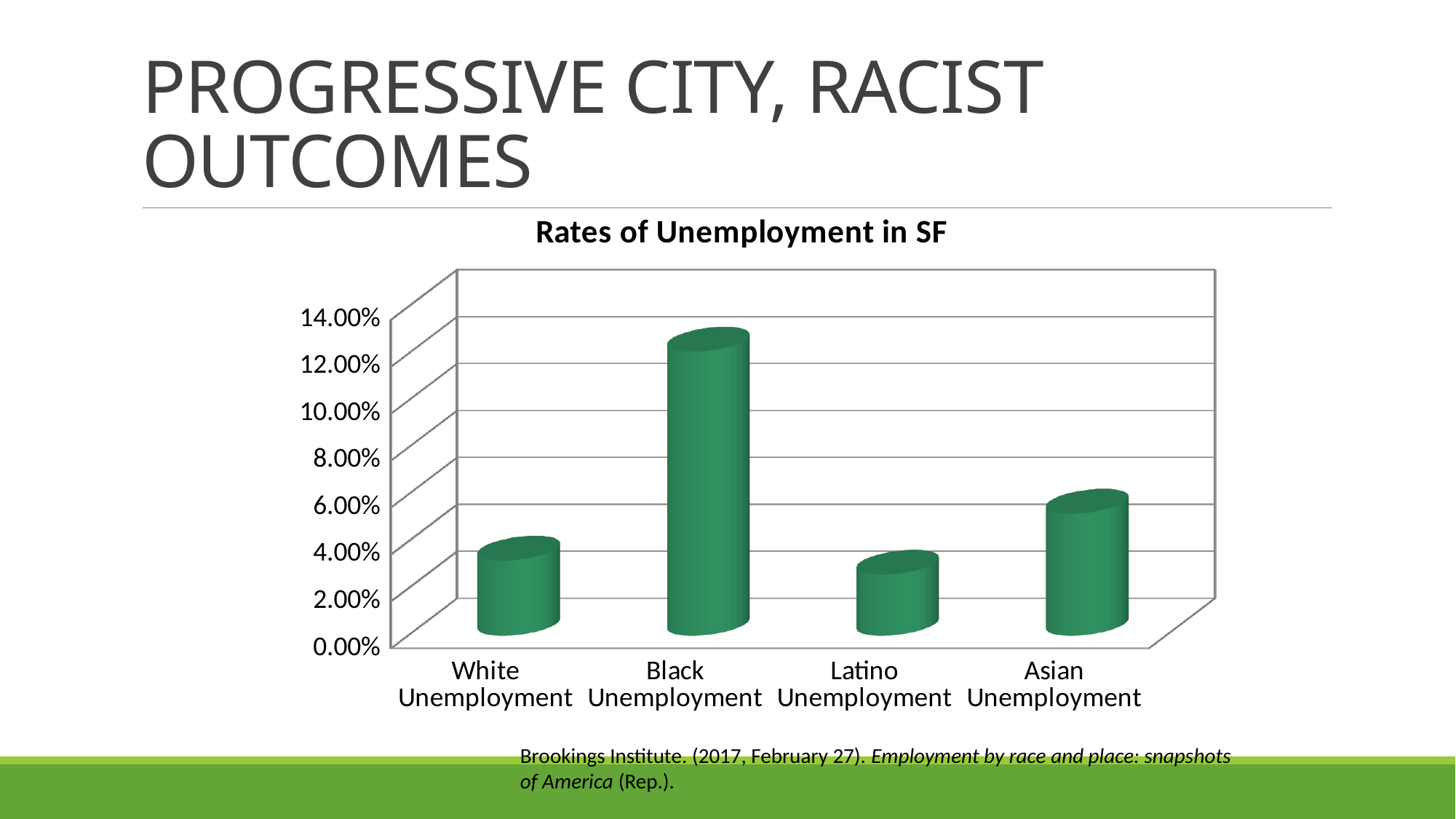
Which category has the highest unemployment rate? Black Unemployment Which is larger, the value for Asian Unemployment or White Unemployment? Asian Unemployment Which category has the lowest unemployment rate? Latino Unemployment What is the title of the chart? Rates of Unemployment in SF How many categories are plotted in the chart? 4 Is the value for White Unemployment greater or less than 6.00%? less What kind of chart is shown on the slide? bar chart Is the value for Asian Unemployment greater or less than 8.00%? less Is the value for Black Unemployment greater or less than 10.00%? greater What is the highest value shown on the vertical axis? 14.00%